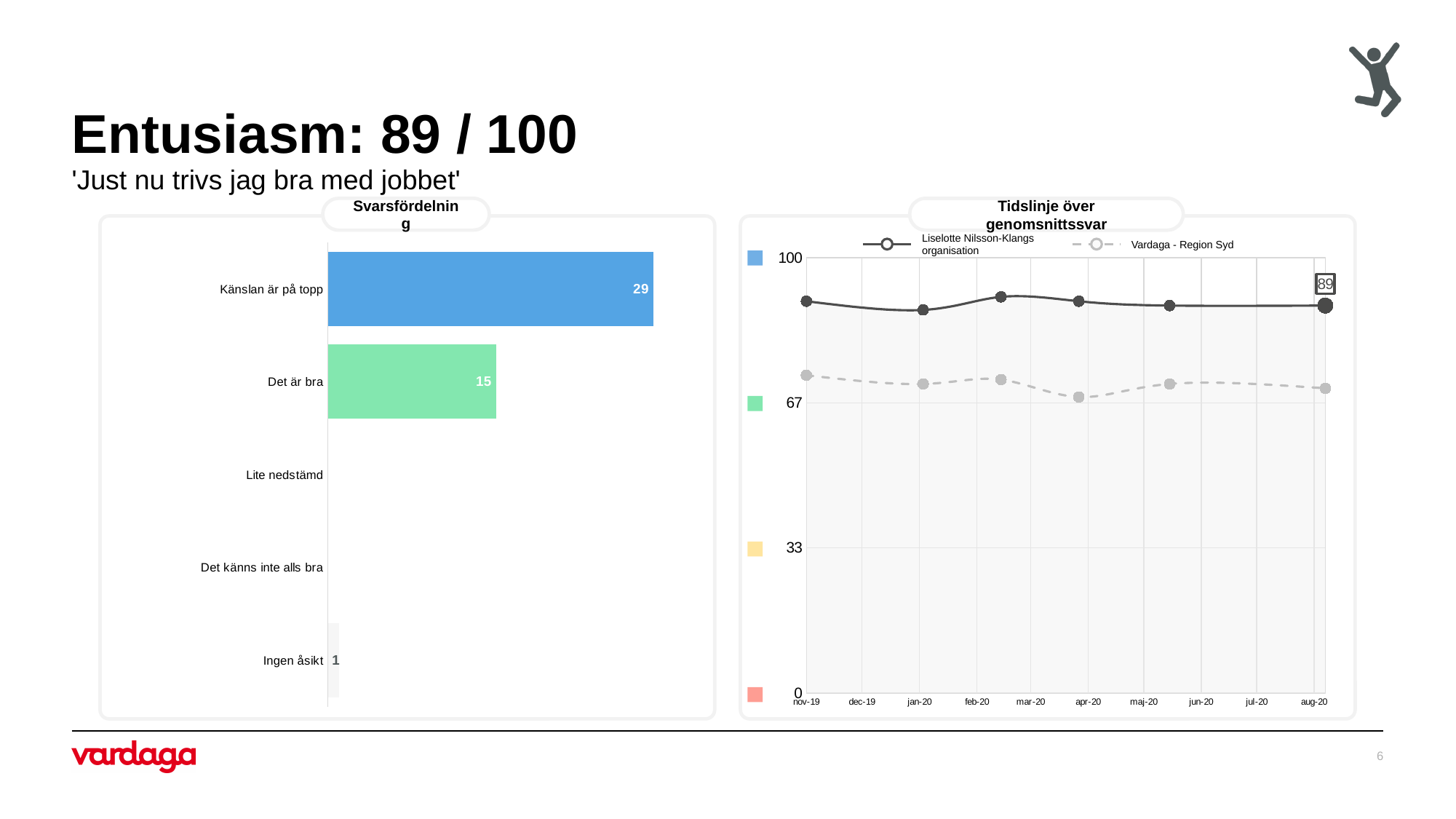
In the Svarsfördelning chart, what is the difference between 'Känslan är på topp' and 'Det är bra'? 14 In the Tidslinje över genomsnittssvar chart, which series is higher at aug-20: Liselotte Nilsson-Klangs organisation or Vardaga - Region Syd? Liselotte Nilsson-Klangs organisation In the Svarsfördelning chart, which is larger: 'Det är bra' or 'Ingen åsikt'? Det är bra In the Svarsfördelning chart, what is the value for 'Känslan är på topp'? 29 In the Svarsfördelning chart, how many categories are listed on the axis? 5 In the Svarsfördelning chart, what is the value for 'Ingen åsikt'? 1 In the Svarsfördelning chart, which category has the highest value? Känslan är på topp In the Tidslinje över genomsnittssvar chart, what is the value for the Liselotte Nilsson-Klangs organisation series at aug-20? 89 In the Tidslinje över genomsnittssvar chart, how many series does the legend list? 2 What kind of chart is the Svarsfördelning chart? Bar chart In the Svarsfördelning chart, what is the value for 'Det är bra'? 15